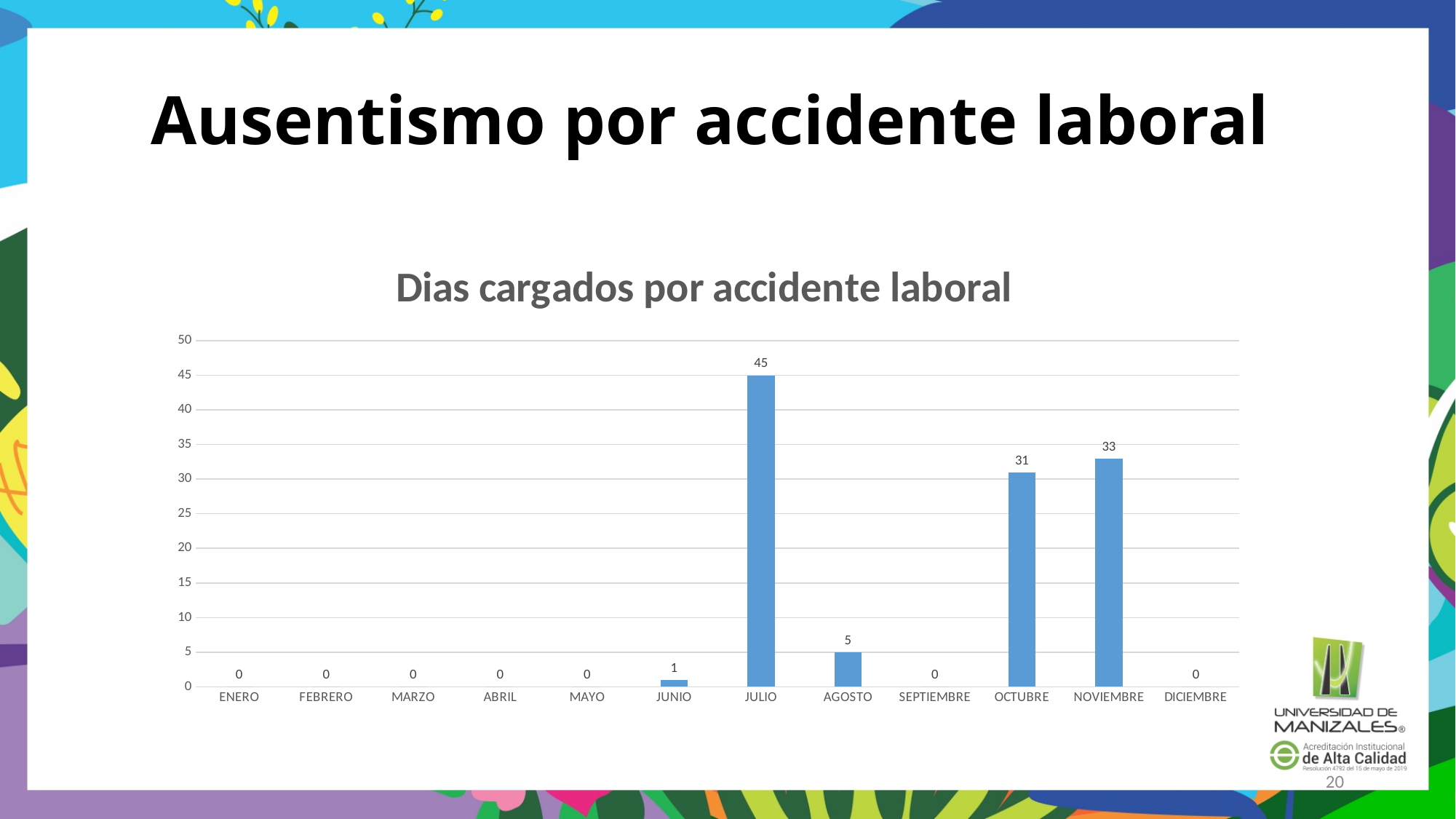
What is the difference between the values for JULIO and NOVIEMBRE? 12 Which is larger, the value for OCTUBRE or the value for AGOSTO? OCTUBRE How many months are shown on the x axis? 12 What is the title of the chart? Dias cargados por accidente laboral What is the value for AGOSTO? 5 Which month has the highest value? JULIO What is the value for JULIO? 45 What kind of chart is shown? bar chart What is the value for JUNIO? 1 What is the value for NOVIEMBRE? 33 What is the value for OCTUBRE? 31 What is the difference between the values for NOVIEMBRE and OCTUBRE? 2